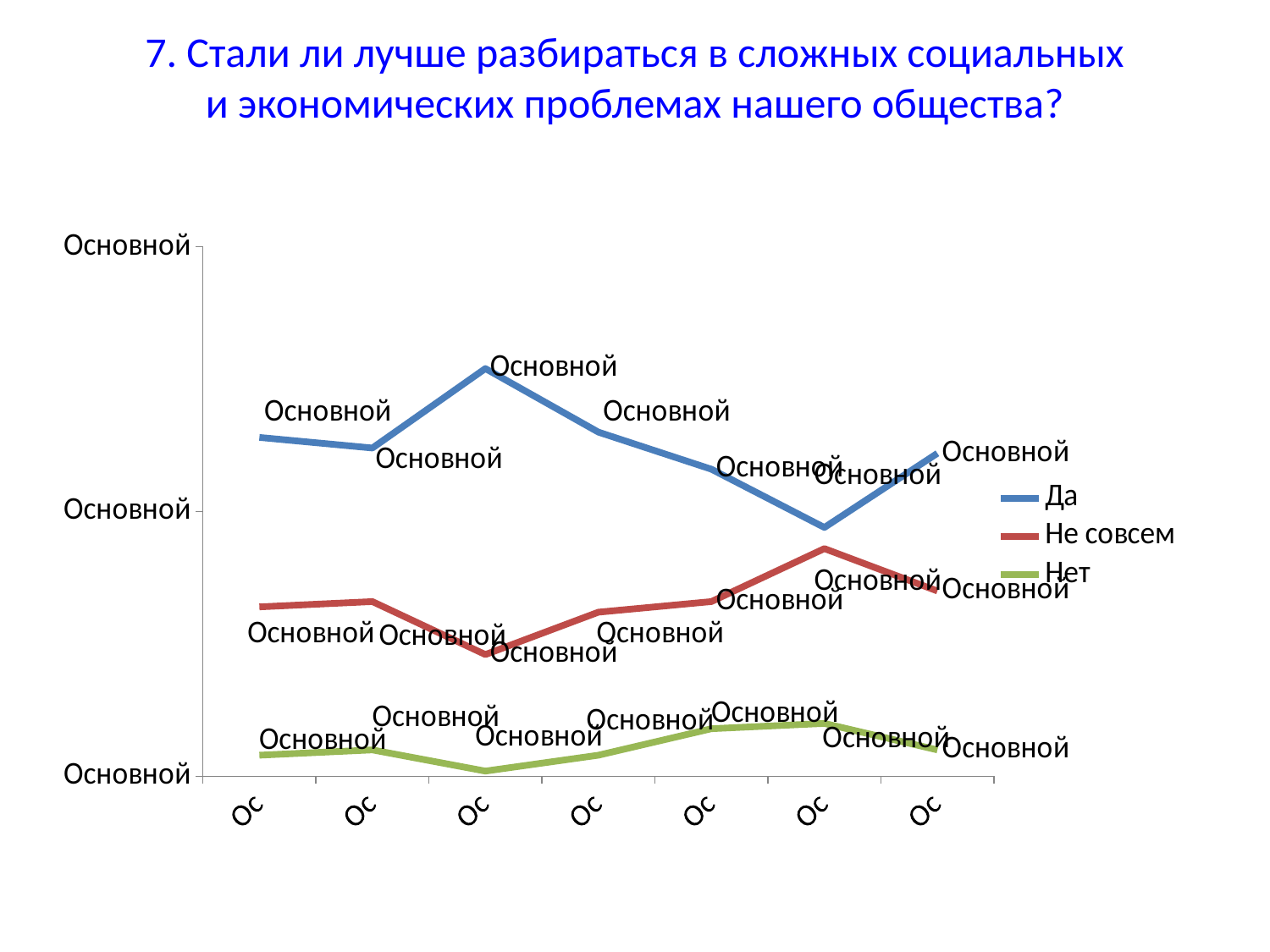
Which series has the highest values across the chart? Да At the third point from the left, which series is larger: 'Да' or 'Не совсем'? Да At which point from the left does the 'Да' line reach its lowest value? the sixth point Which series has the lowest values across the chart? Нет At which point from the left does the 'Да' line reach its highest value? the third point How many data points does each line have? 7 What kind of chart is shown on the slide? line chart At which point from the left does the 'Не совсем' line reach its lowest value? the third point At which point from the left does the 'Не совсем' line reach its highest value? the sixth point What colour is the line for the 'Нет' series? green How many series does the legend list? 3 What are the series names listed in the legend? Да, Не совсем, Нет